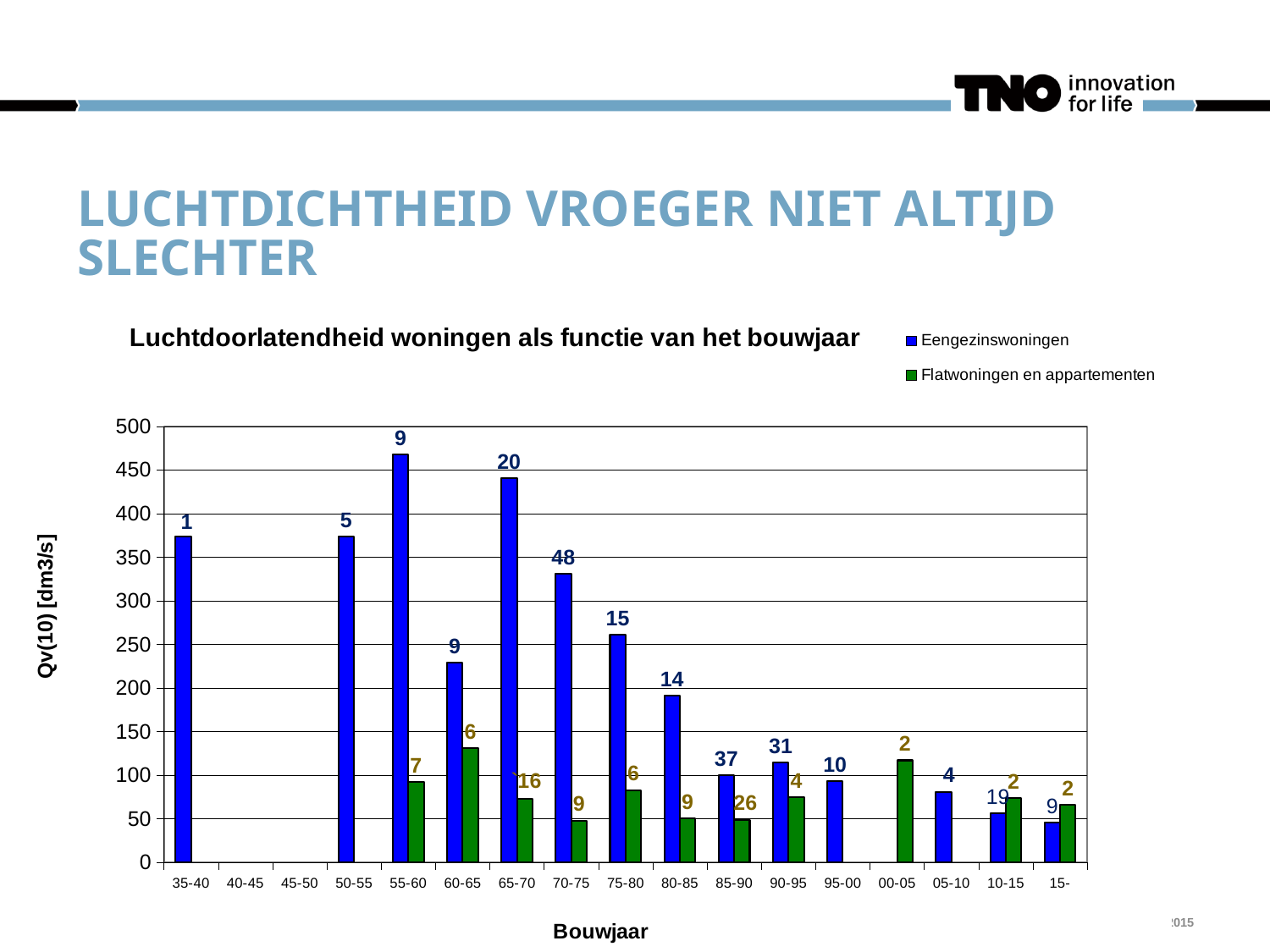
Which is larger for Eengezinswoningen: the value for 60-65 or the value for 65-70? 65-70 Which building-year category has the highest value for Flatwoningen en appartementen? 60-65 What is the label of the y axis? Qv(10) [dm3/s] Which building-year category has the highest value for Eengezinswoningen? 55-60 How many building-year categories are shown on the x axis? 17 What kind of chart is shown on the slide? bar chart Do the Eengezinswoningen values generally rise or fall from 65-70 to 15- along the x axis? fall Is the value for Eengezinswoningen in 55-60 greater or less than 450? greater Which building-year category has the lowest value for Eengezinswoningen? 15- How many series does the legend list? 2 Is the value for Eengezinswoningen in 80-85 greater or less than 200? less Is the value for Flatwoningen en appartementen in 00-05 greater or less than 100? greater